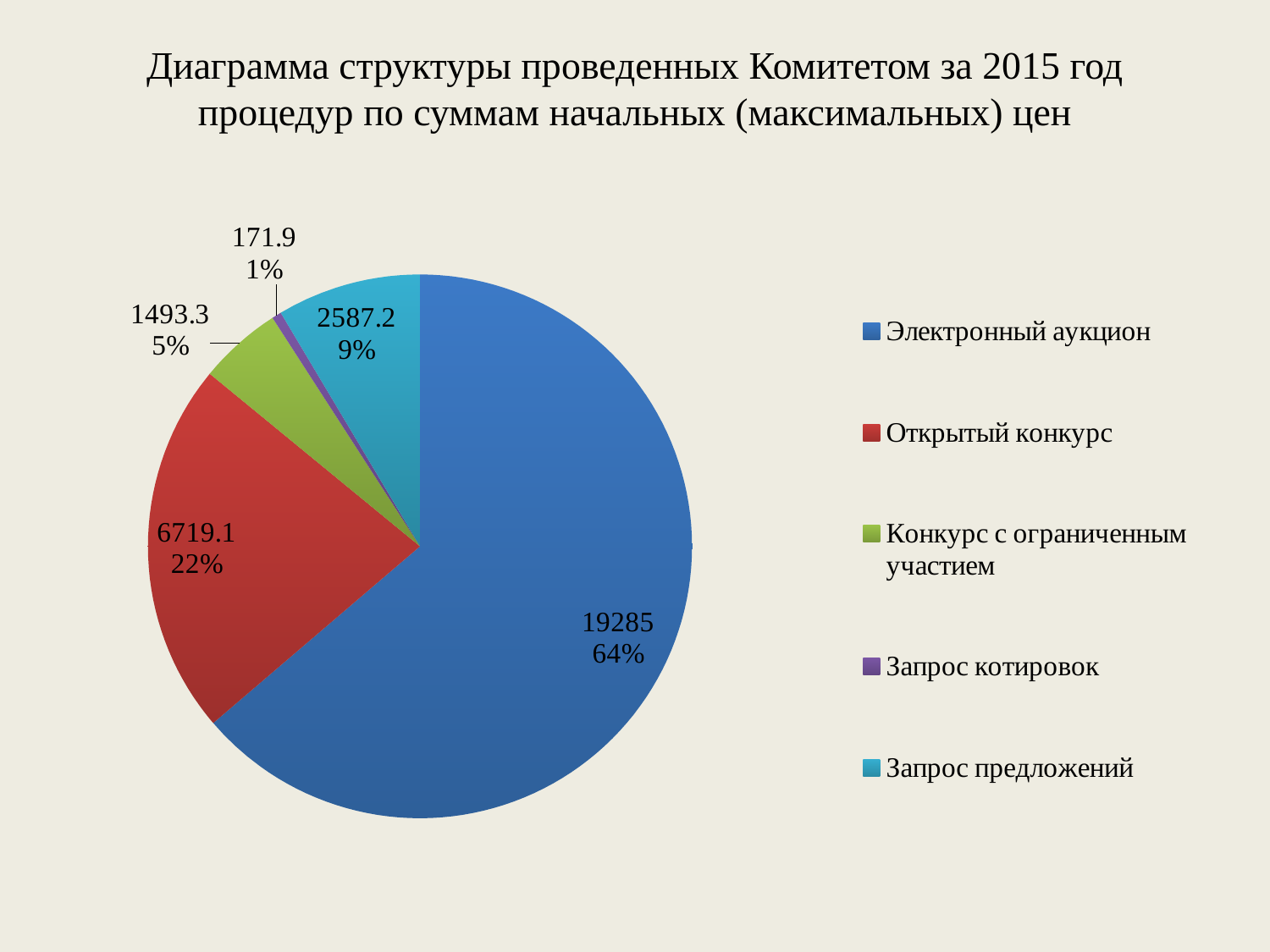
What is the value for Запрос предложений? 2587.2 What is the value for Запрос котировок? 171.9 What share of the pie does Конкурс с ограниченным участием represent? 5% Which category has the largest slice? Электронный аукцион What is the value for Открытый конкурс? 6719.1 How many categories does the legend list? 5 Which is larger, the value for Конкурс с ограниченным участием or the value for Запрос предложений? Запрос предложений What kind of chart is shown on the slide? pie chart What is the value for Электронный аукцион? 19285 What is the difference between the values for Открытый конкурс and Запрос предложений? 4131.9 Which category has the smallest slice? Запрос котировок What share of the pie does Электронный аукцион represent? 64%